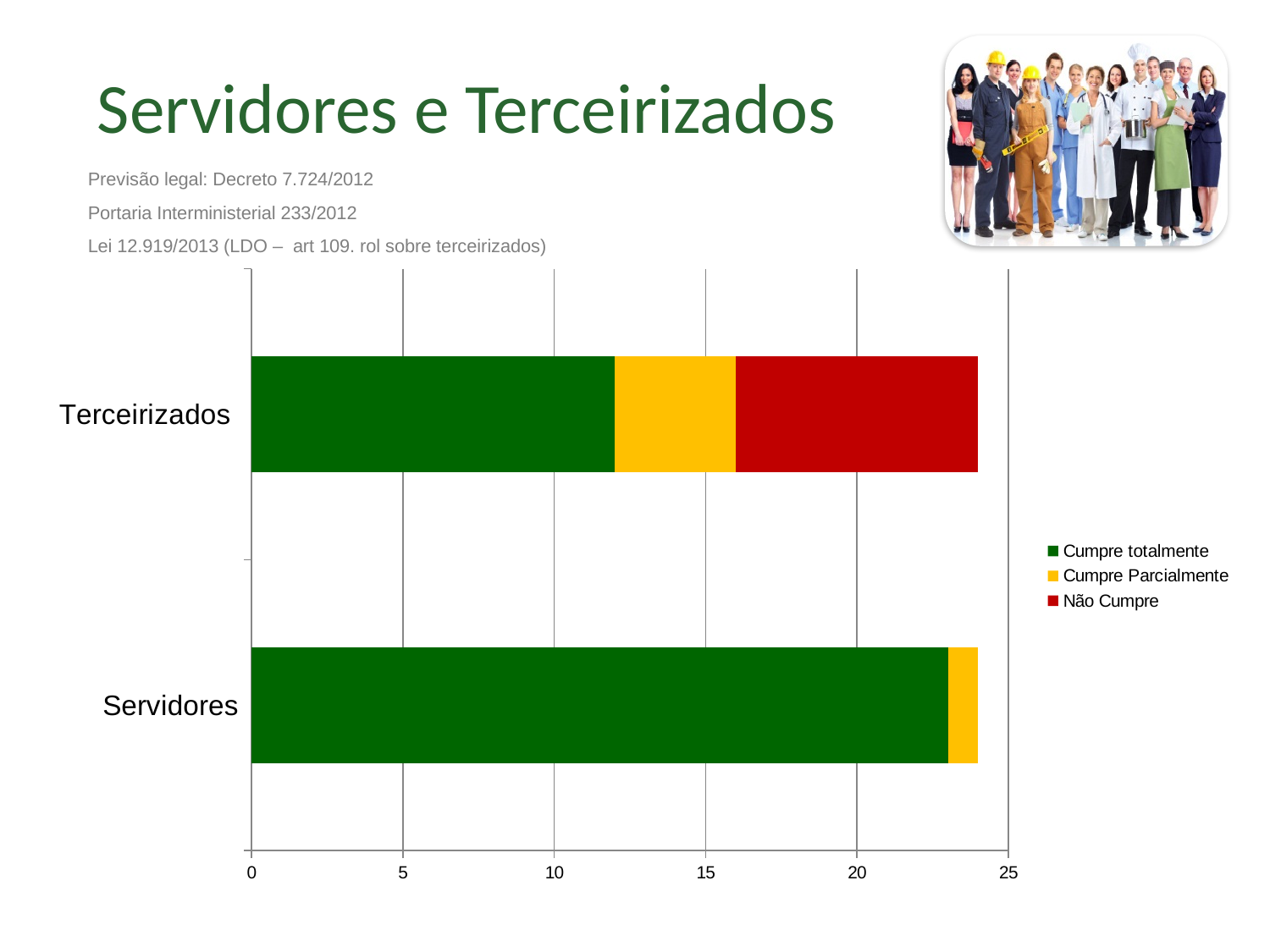
Which category has the larger Cumpre Parcialmente value, Servidores or Terceirizados? Terceirizados What colour represents the Não Cumpre series in the legend? red How many categories are plotted on the chart? 2 What kind of chart is shown on the slide? bar chart How many series does the chart legend list? 3 Which category has the larger Cumpre totalmente value, Servidores or Terceirizados? Servidores Which category is shown at the top of the chart? Terceirizados Which category has the larger Não Cumpre value, Servidores or Terceirizados? Terceirizados Is the Cumpre totalmente value for Terceirizados greater or less than 15? less Is the total length of the Terceirizados stacked bar greater or less than 20? greater Is the Cumpre totalmente value for Terceirizados greater or less than 10? greater